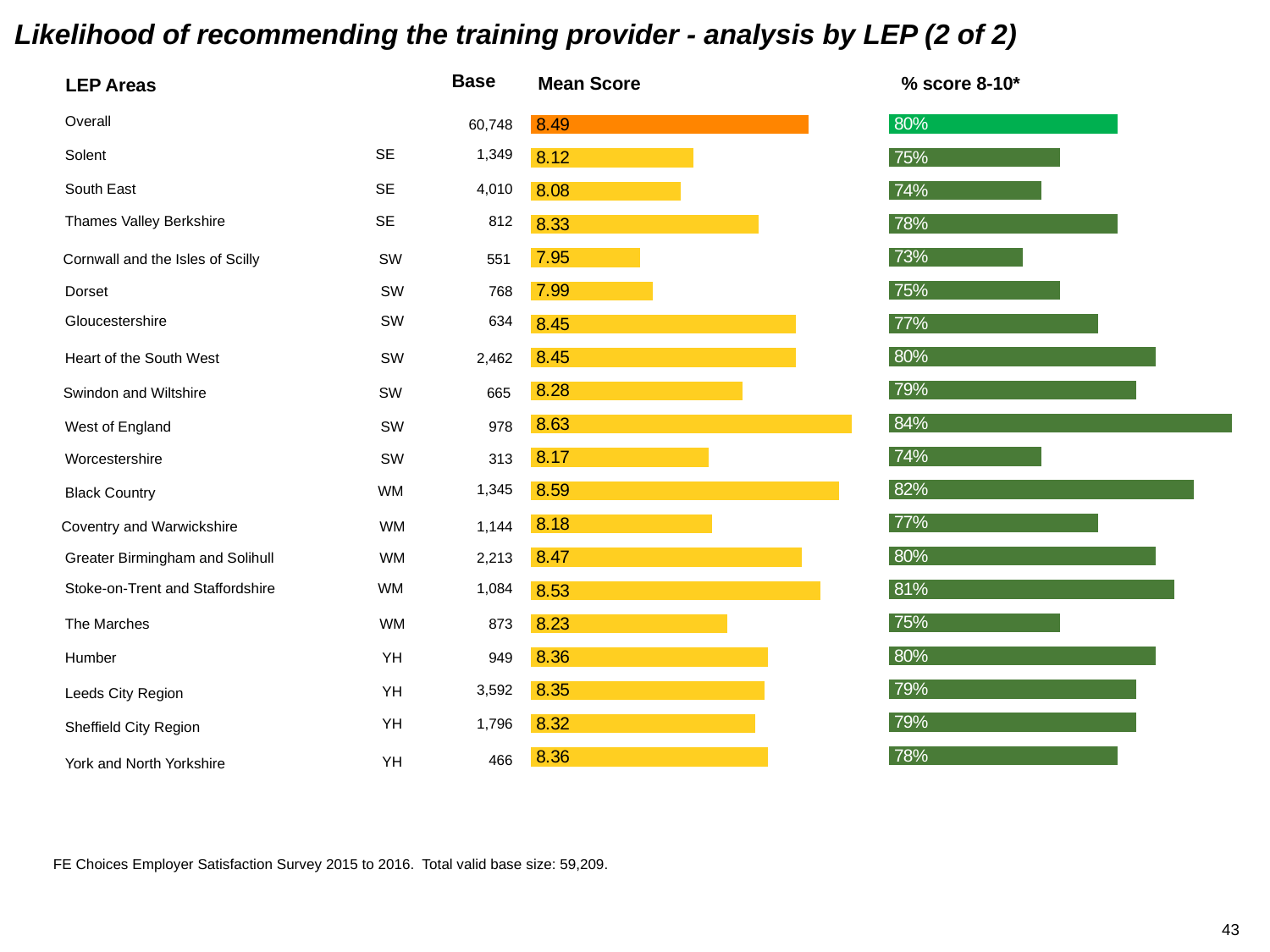
In the Mean Score chart, what is the mean score for Cornwall and the Isles of Scilly? 7.95 In the Mean Score chart, what is the mean score for West of England? 8.63 In the % score 8-10* chart, what is the value for Overall? 80% What type of chart is used to show the % score 8-10* values? Bar chart In the % score 8-10* chart, what is the difference between the values for West of England and South East? 10% In the % score 8-10* chart, which LEP area has the lowest value? Cornwall and the Isles of Scilly In the Mean Score chart, which LEP area has the highest mean score? West of England In the Mean Score chart, what is the difference between the mean scores for West of England and Cornwall and the Isles of Scilly? 0.68 In the Mean Score chart, which bar is coloured differently (orange) from the others? Overall How many LEP area bars (including Overall) are shown in the Mean Score chart? 20 In the % score 8-10* chart, what is the value for Black Country? 82% In the Mean Score chart, which is larger, the mean score for Black Country or for Solent? Black Country